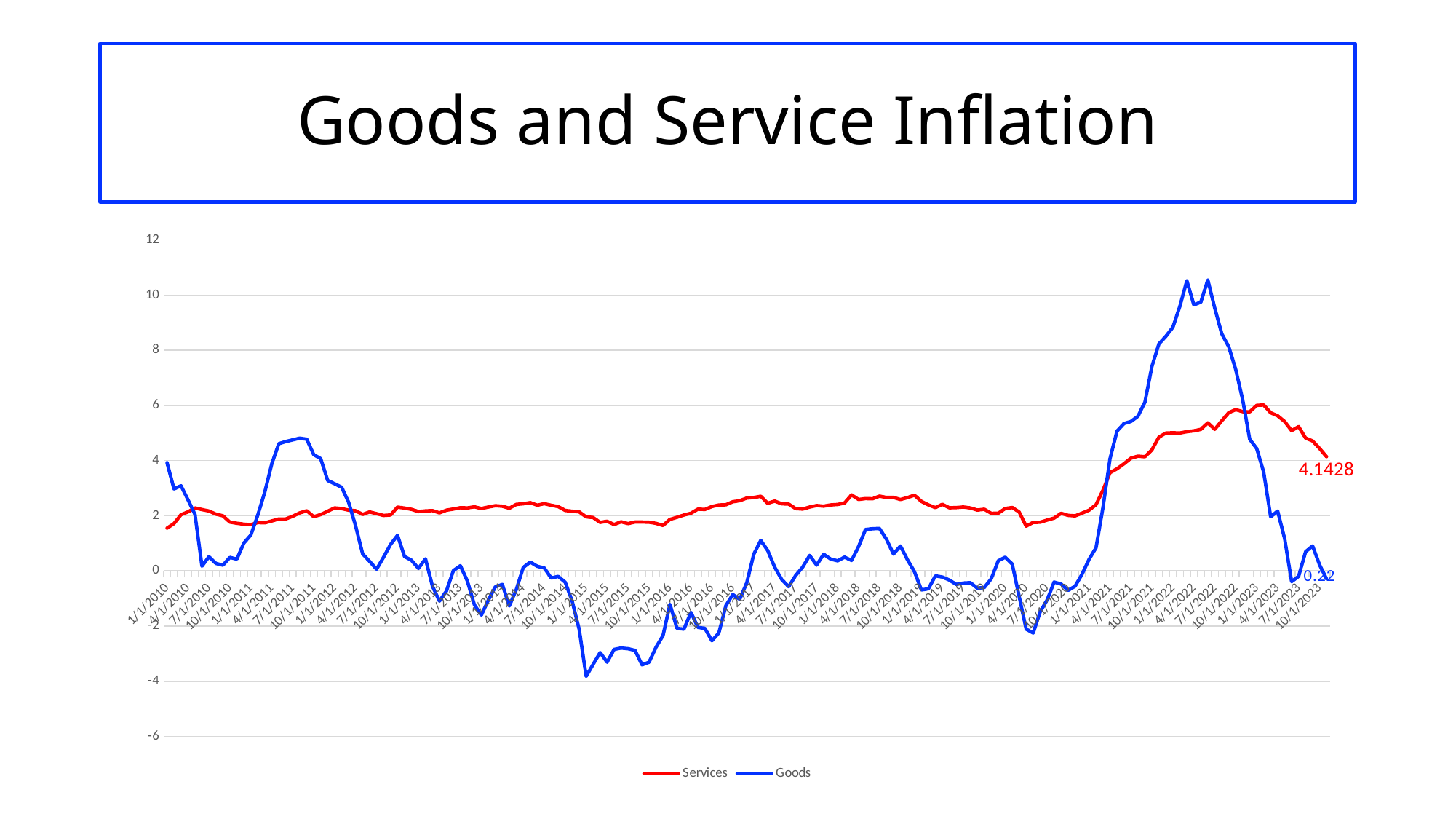
Is the lowest value reached by the Goods series greater or less than -2? less What is the difference between the final labelled values of Services (4.1428) and Goods (0.22)? 3.9228 What is the final labelled value of the Services series? 4.1428 Which series reaches the highest value anywhere on the chart? Goods Is the highest value reached by the Services series greater or less than 8? less At the end of the series, which is larger: Services or Goods? Services What kind of chart is shown on the slide? line chart Is the highest value reached by the Goods series greater or less than 10? greater What is the final labelled value of the Goods series? 0.22 What is the title of the slide? Goods and Service Inflation What are the two series named in the legend? Services and Goods How many series does the legend list? 2